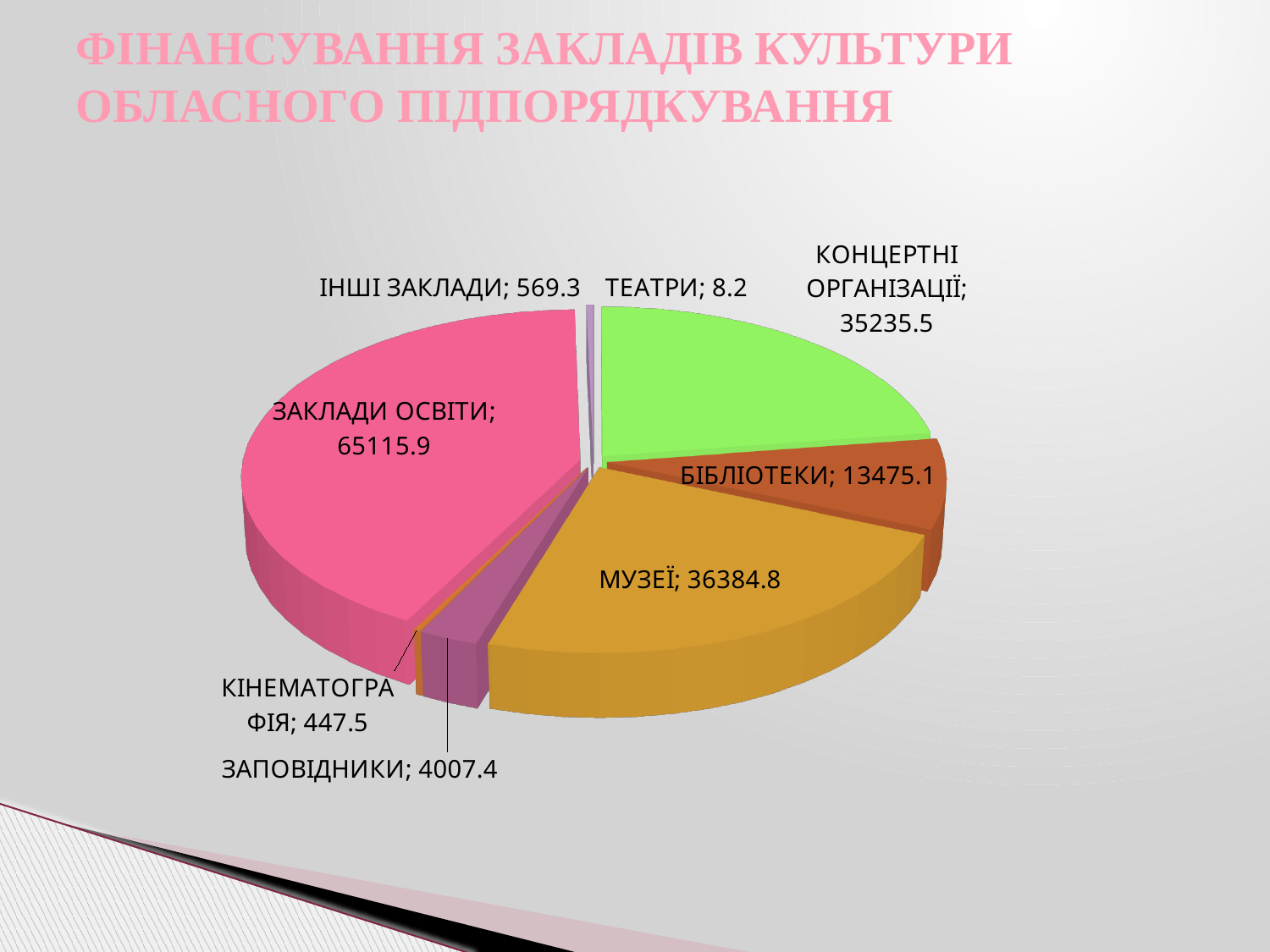
Which is larger, МУЗЕЇ or КОНЦЕРТНІ ОРГАНІЗАЦІЇ? МУЗЕЇ Which category has the smallest value? ТЕАТРИ What is the value for ТЕАТРИ? 8.2 What is the title of the slide? ФІНАНСУВАННЯ ЗАКЛАДІВ КУЛЬТУРИ ОБЛАСНОГО ПІДПОРЯДКУВАННЯ Which category has the largest slice? ЗАКЛАДИ ОСВІТИ What is the value for ЗАКЛАДИ ОСВІТИ? 65115.9 What is the difference between the values for МУЗЕЇ and КОНЦЕРТНІ ОРГАНІЗАЦІЇ? 1149.3 What is the value for БІБЛІОТЕКИ? 13475.1 What kind of chart is shown on the slide? Pie chart How many categories does the pie chart show? 8 What is the value for МУЗЕЇ? 36384.8 What is the value for ЗАПОВІДНИКИ? 4007.4